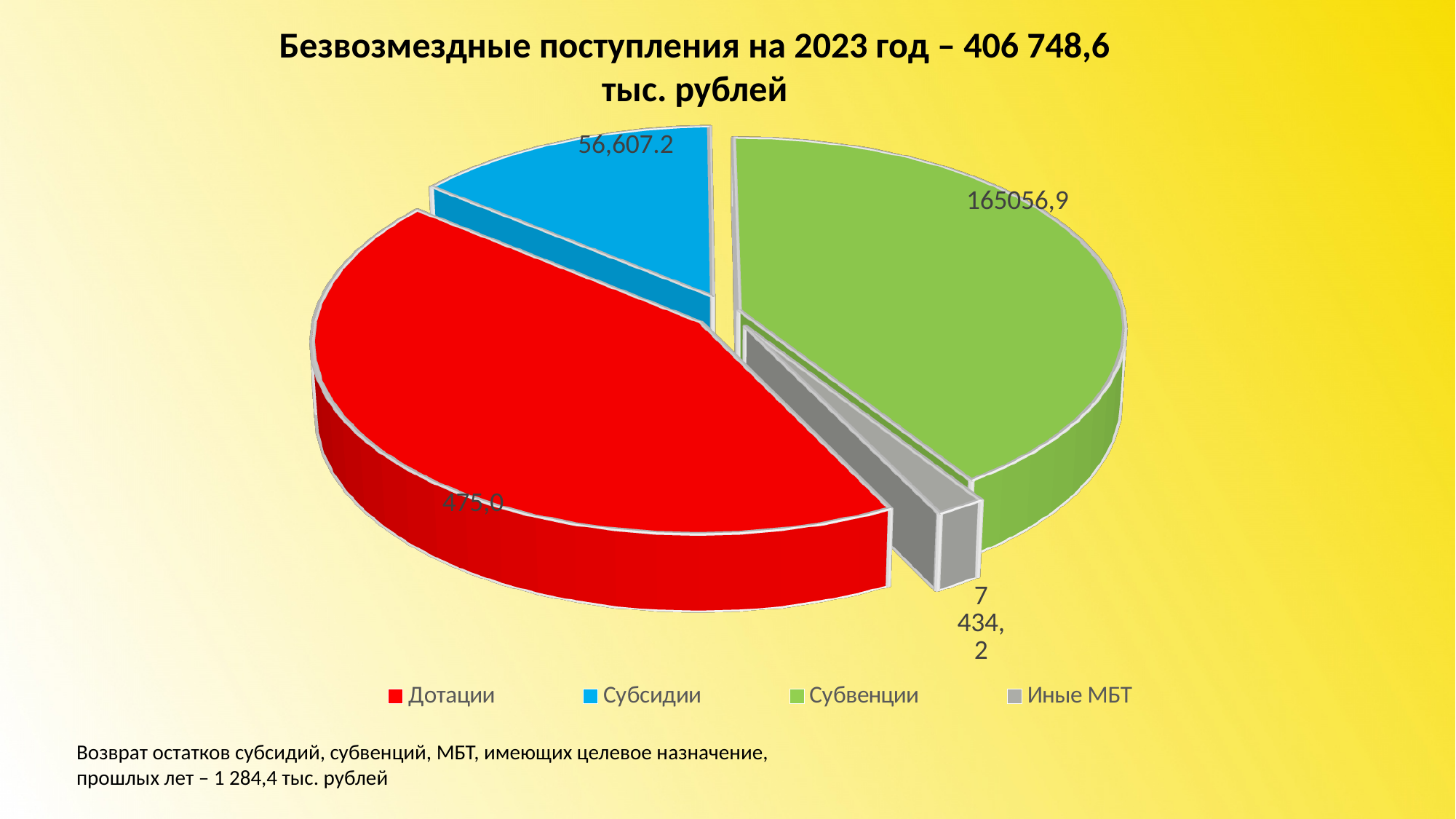
What colour is the Дотации slice? red Which category has the smallest slice of the pie? Иные МБТ Which is larger, Субсидии or Субвенции? Субвенции How many entries does the legend list? 4 How many slices does the pie chart have? 4 What total amount is stated in the chart title? 406 748,6 тыс. рублей Which is larger, Дотации or Иные МБТ? Дотации Which is larger, Иные МБТ or Субсидии? Субсидии What is the value shown for Субвенции? 165056,9 What is the value shown for Субсидии? 56,607.2 What kind of chart is shown on the slide? pie chart What is the value shown for Иные МБТ? 7 434,2